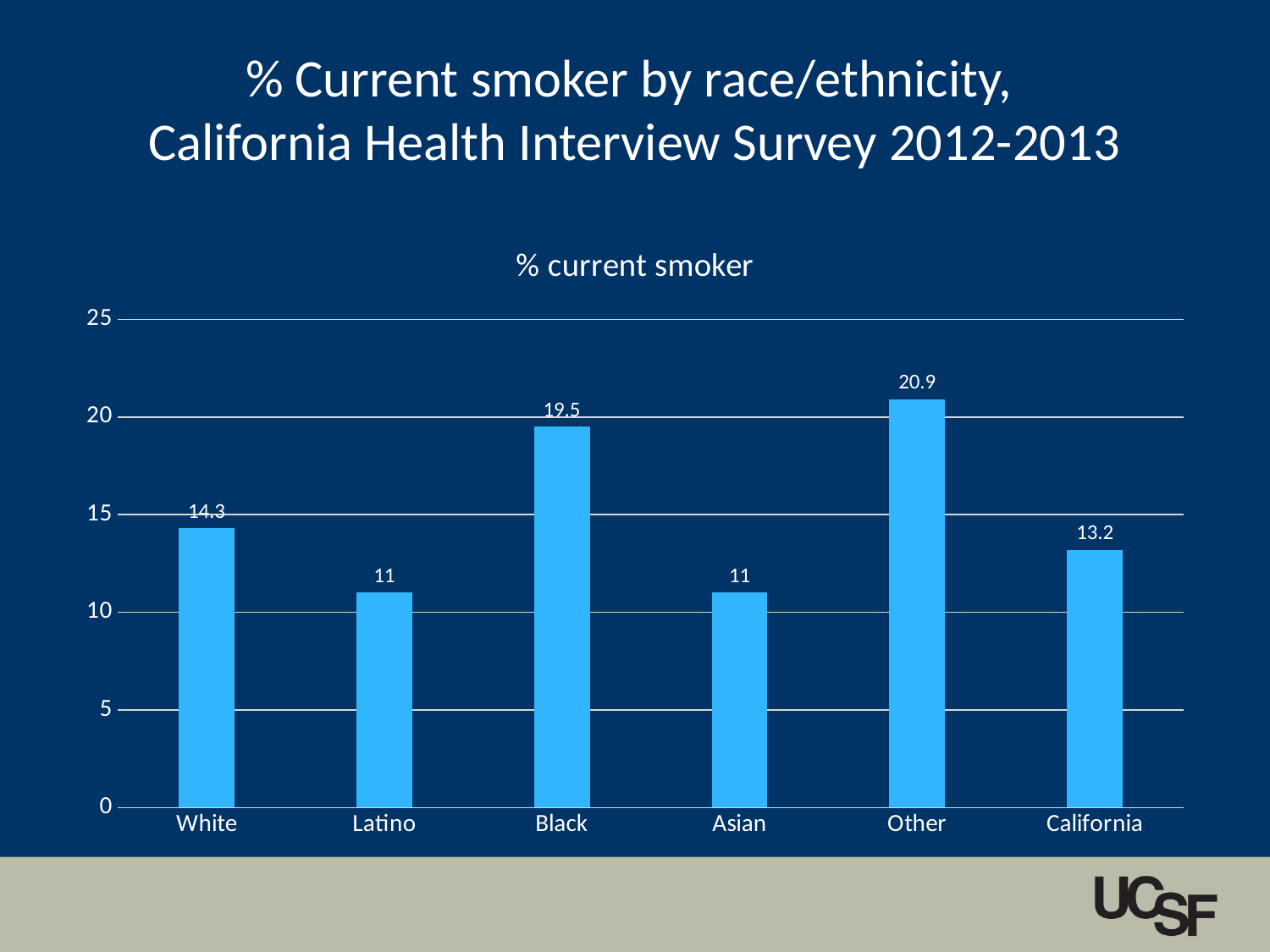
What is the difference between the % current smoker values for White and California? 1.1 What is the % current smoker value for White? 14.3 Which has a larger % current smoker value, Black or White? Black What is the title shown above the chart area? % current smoker What is the % current smoker value for Black? 19.5 How many categories are shown on the x axis? 6 Which category has the highest % current smoker value? Other What is the difference between the % current smoker values for Other and Black? 1.4 What kind of chart is shown on the slide? Bar chart Is the value for Other greater or less than 20? greater What is the % current smoker value for California? 13.2 Which categories share the lowest % current smoker value? Latino and Asian